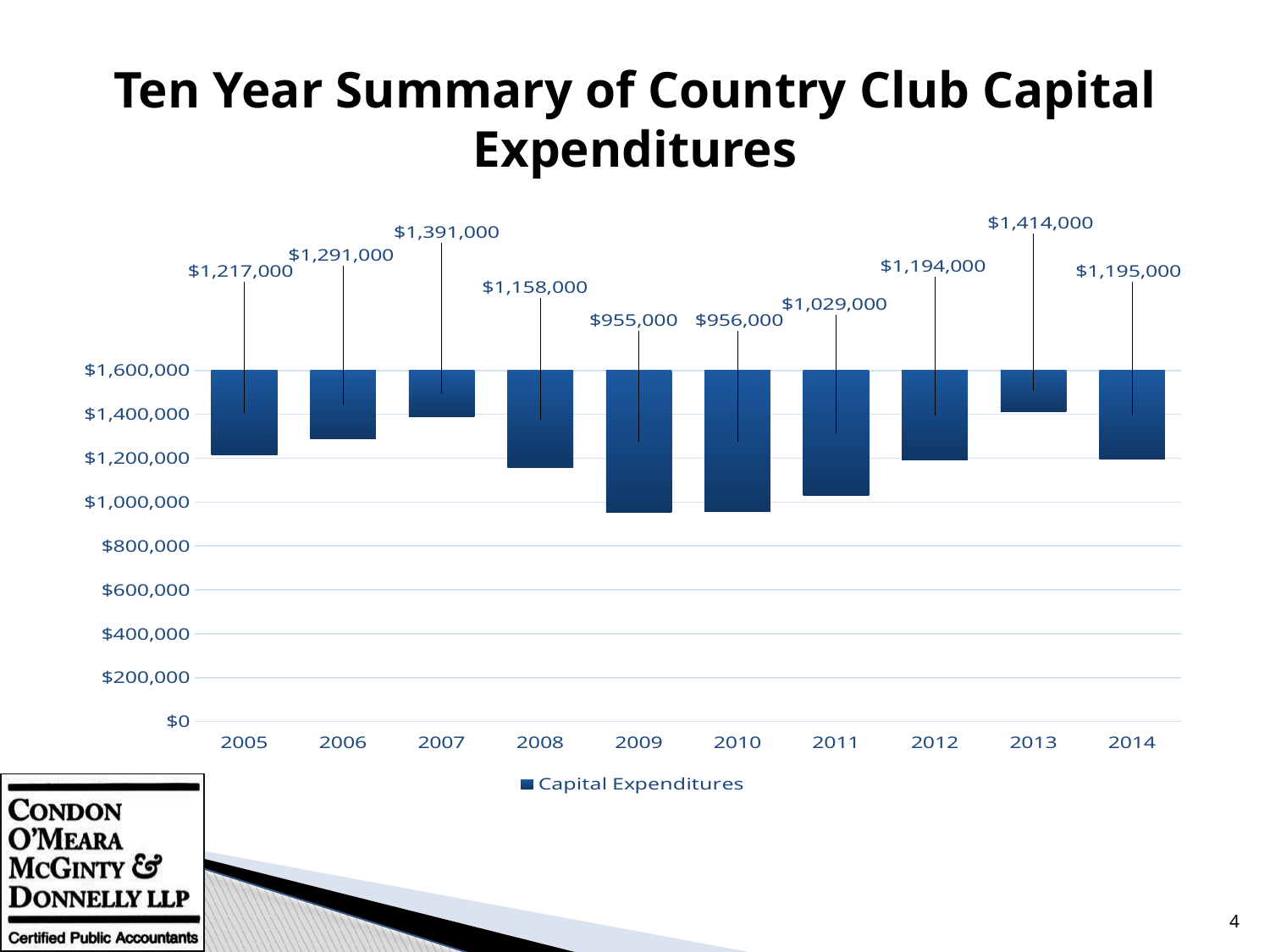
Which year had higher Capital Expenditures, 2006 or 2014? 2006 Which year has the lowest Capital Expenditures? 2009 Which year has the highest Capital Expenditures? 2013 What kind of chart is shown on the slide? Bar chart What is the difference between Capital Expenditures in 2013 and 2005? $197,000 How many series does the legend list? 1 What is the value of Capital Expenditures for 2007? $1,391,000 How many years are shown on the x axis of the chart? 10 What is the value of Capital Expenditures for 2013? $1,414,000 What is the difference between Capital Expenditures in 2007 and 2008? $233,000 What is the value of Capital Expenditures for 2009? $955,000 Do Capital Expenditures rise or fall from 2009 to 2013? Rise